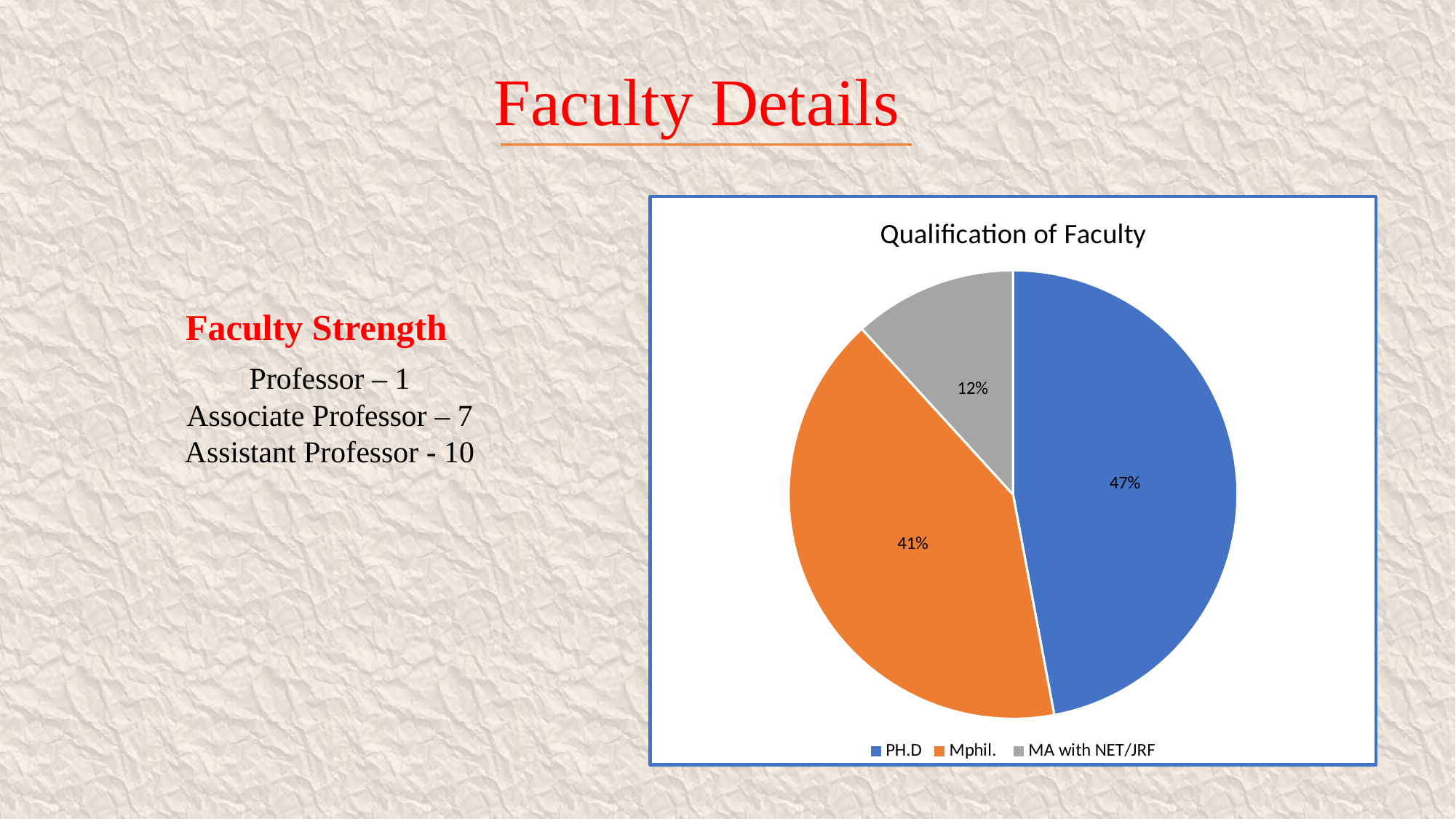
Which colour represents Mphil. in the pie chart? orange What share of the pie does Mphil. represent? 41% What share of the pie does MA with NET/JRF represent? 12% What type of chart is shown on the slide? pie chart What share of the pie does PH.D represent? 47% Which qualification has the largest share of the pie? PH.D Which qualification has the smallest share of the pie? MA with NET/JRF How many slices does the pie chart have? 3 Which is larger, the share for Mphil. or the share for MA with NET/JRF? Mphil. What is the difference in percentage points between the PH.D share and the Mphil. share? 6% What is the title of the chart? Qualification of Faculty What is the difference in percentage points between the Mphil. share and the MA with NET/JRF share? 29%